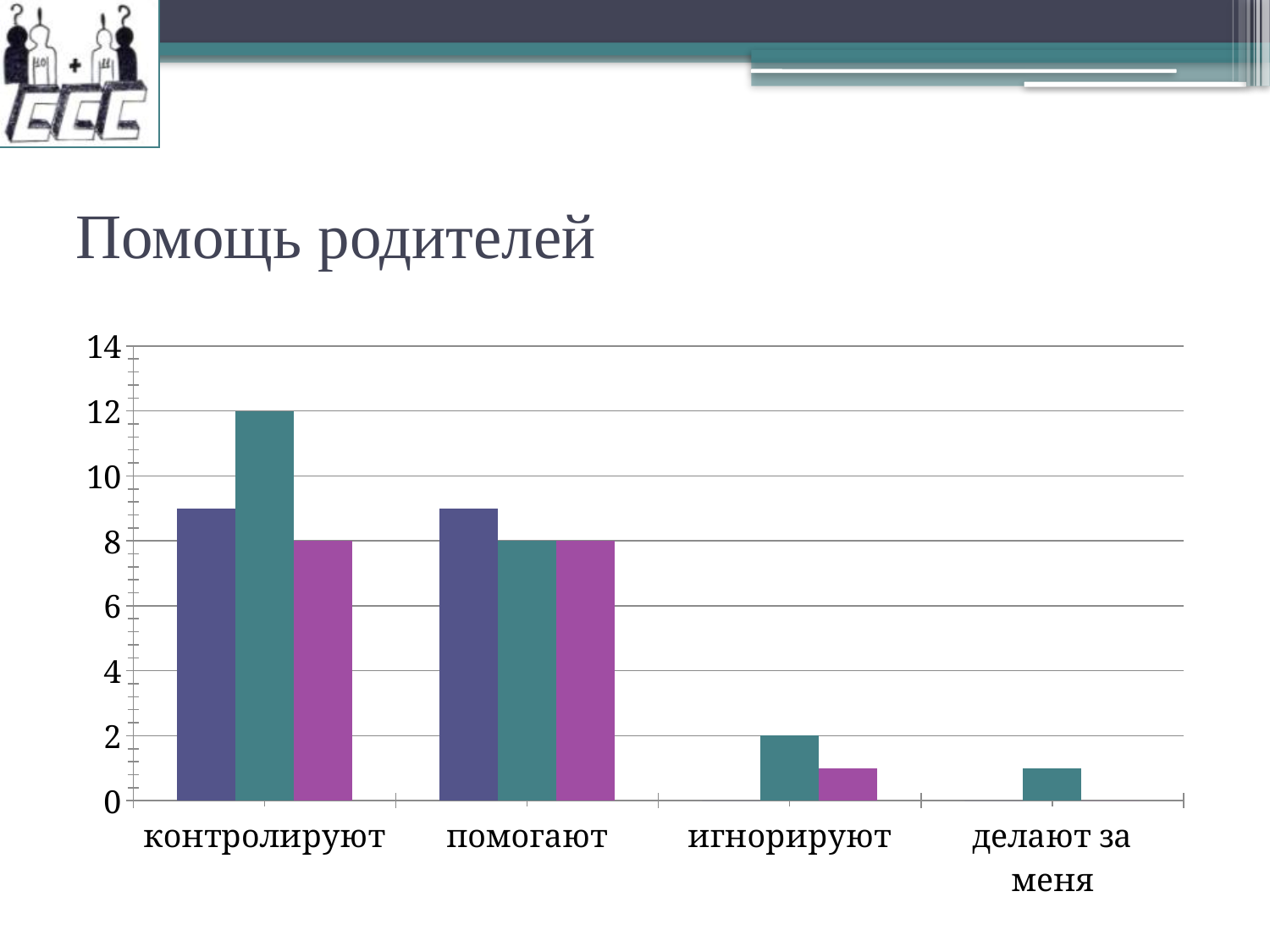
What is the value of the teal bar for игнорируют? 2 Is the value of the dark blue bar for контролируют greater or less than 8? greater Which category has the tallest bar in the chart? контролируют What is the difference between the teal bar for контролируют and the teal bar for помогают? 4 Which is larger: the teal bar for контролируют or the teal bar for помогают? контролируют What is the value of the teal bar for контролируют? 12 Is the value of the magenta bar for игнорируют greater or less than 2? less How many categories are shown on the x axis? 4 What kind of chart is shown on the slide? bar chart What is the value of the magenta bar for контролируют? 8 What is the title of the chart? Помощь родителей What is the value of the teal bar for помогают? 8